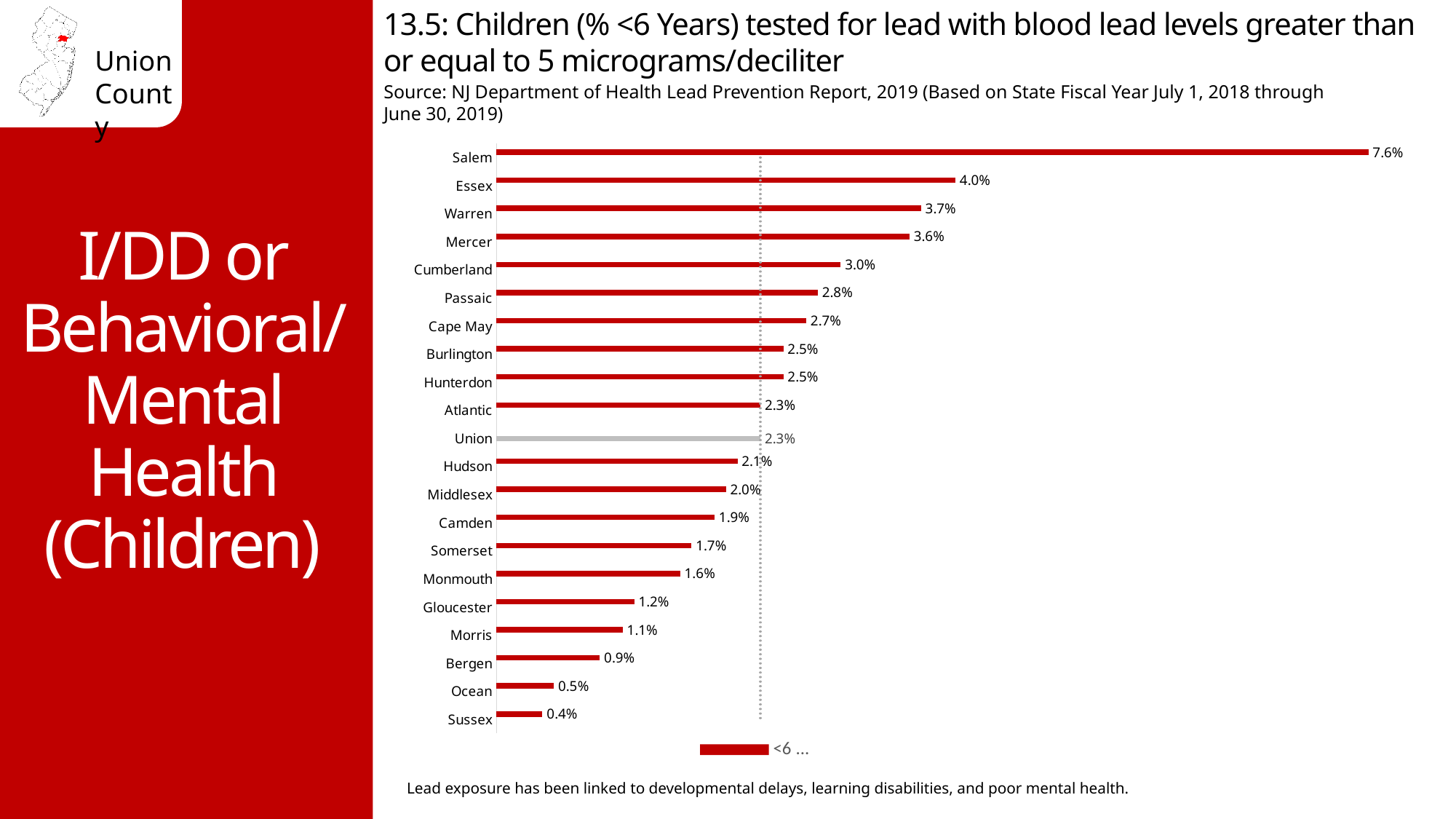
What is the value for Union County? 2.3% Which county has the lowest value? Sussex What is the value for Salem? 7.6% What is the difference between the values for Salem and Essex? 3.6% How many counties are shown in the chart? 21 Which has a larger value, Mercer or Cumberland? Mercer What kind of chart is shown on the slide? Bar chart What is the difference between the values for Union and Sussex? 1.9% Which county's bar is drawn in grey rather than red? Union Which county has the highest value? Salem Which has a larger value, Ocean or Morris? Morris What is the value for Bergen? 0.9%